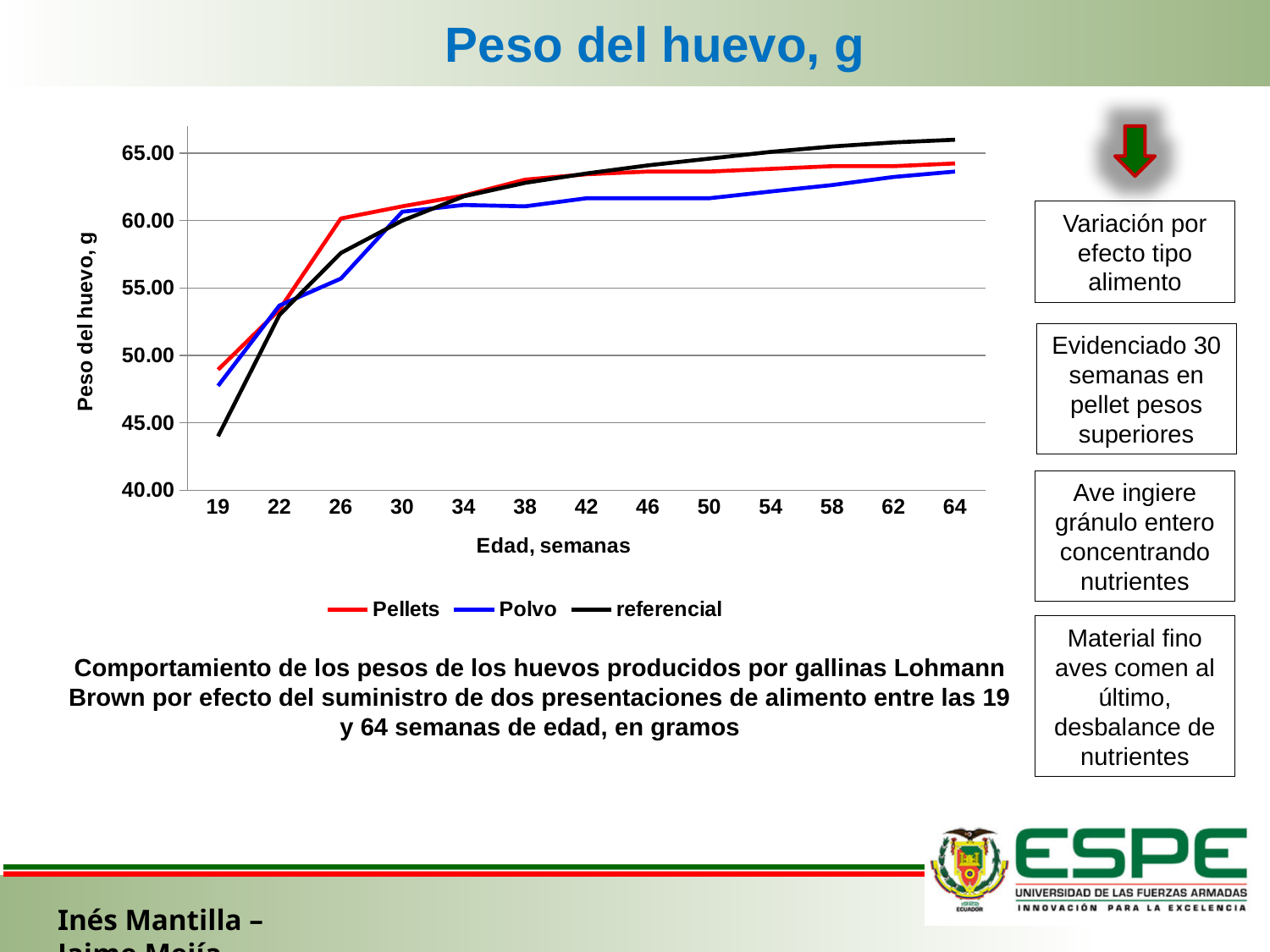
At 19 weeks, which series has the lowest egg weight? referencial Is the value for Pellets at 19 weeks greater or less than 50.00? less Is the value for Polvo at 26 weeks greater or less than 55.00? greater How many series does the legend list? 3 Is the value for referencial at 19 weeks greater or less than 45.00? less At 64 weeks, which is higher: referencial or Polvo? referencial What is the label of the y axis? Peso del huevo, g What kind of chart is shown on the slide? Line chart How many age points (weeks) are shown on the x axis? 13 Does the Pellets series rise or fall as age in weeks increases? Rises